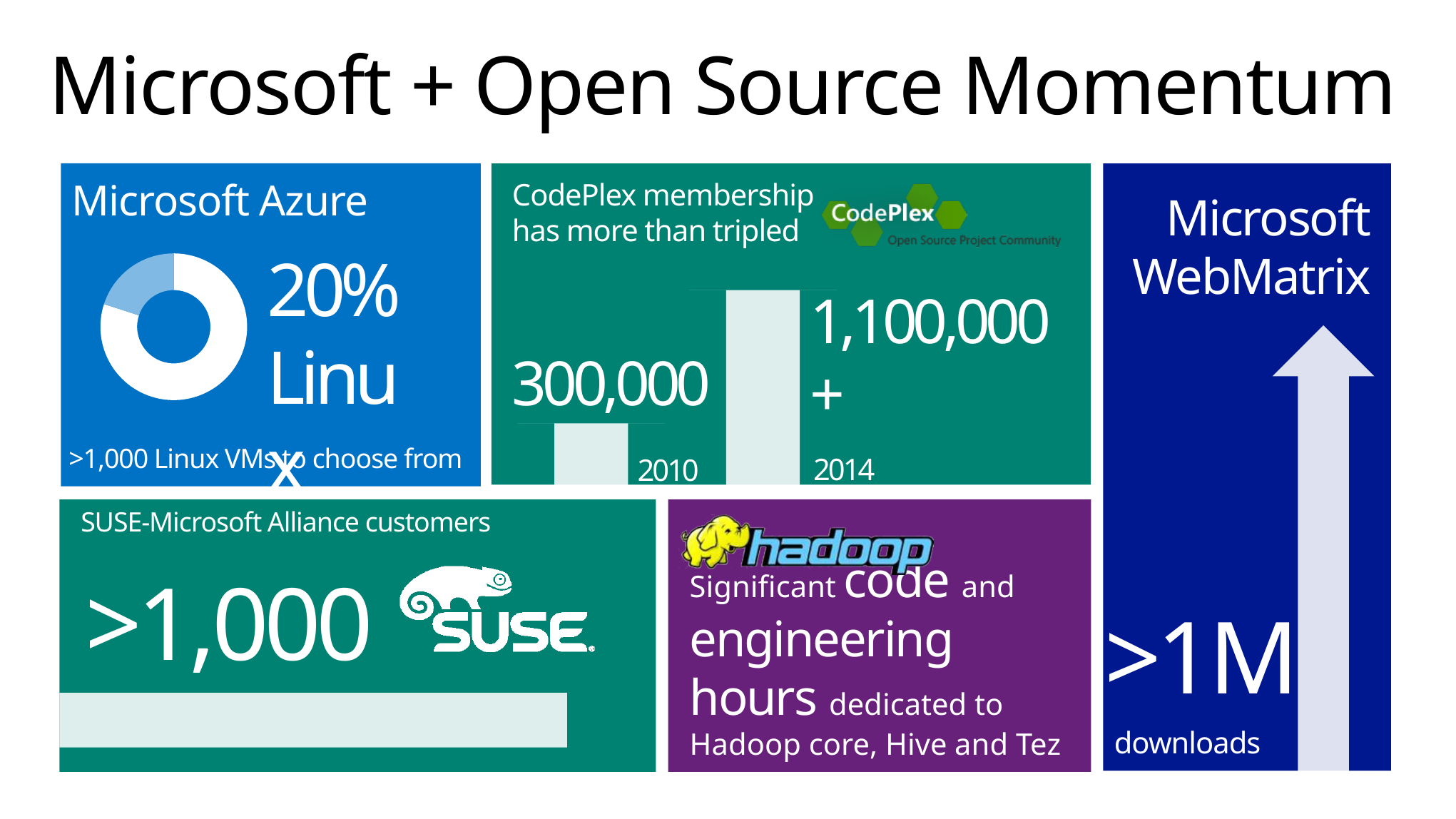
In the Microsoft Azure chart, what percentage is labelled for Linux? 20% In the CodePlex membership chart, how many years (bars) are shown? 2 What is the title text above the CodePlex bar chart? CodePlex membership has more than tripled In the CodePlex membership chart, what is the value for 2010? 300,000 In the CodePlex membership chart, what is the value for 2014? 1,100,000+ What kind of chart is shown in the CodePlex membership panel? Bar chart In the SUSE-Microsoft Alliance customers panel, what value is shown? >1,000 In the CodePlex membership chart, does membership rise or fall from 2010 to 2014? Rises In the Microsoft WebMatrix panel, how many downloads are shown? >1M In the CodePlex membership chart, which year has the lower membership? 2010 What kind of chart is shown in the Microsoft Azure panel? Donut (pie) chart In the CodePlex membership chart, which year has the higher membership? 2014